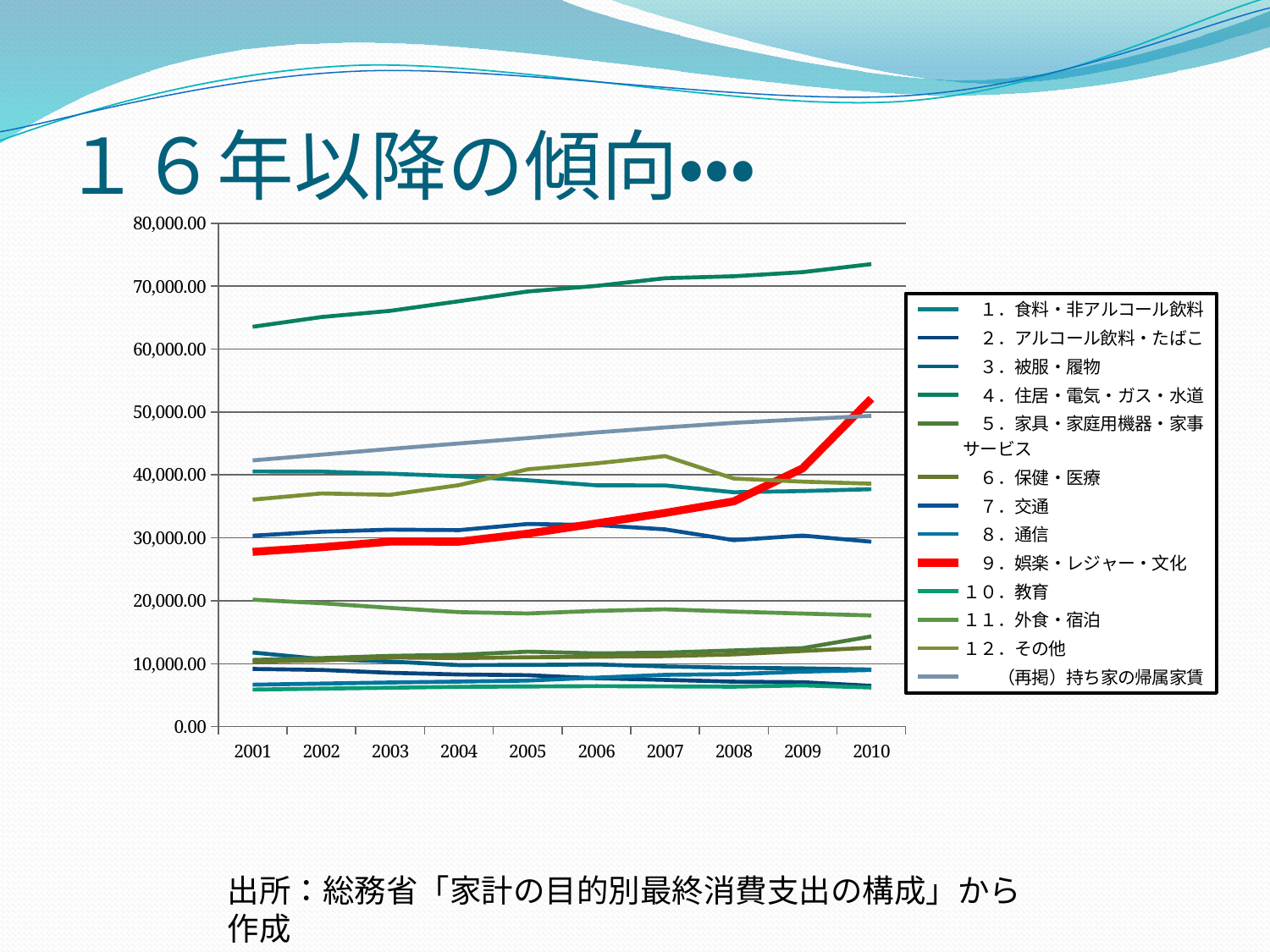
What is the first year shown on the x axis of the chart? 2001 Which series is drawn with the thick red line in the chart? 9．娯楽・レジャー・文化 Does the line for 4．住居・電気・ガス・水道 rise or fall from 2001 to 2010? rise Is the value for 4．住居・電気・ガス・水道 in 2001 greater or less than 60,000.00? greater In 2001, which is larger: 9．娯楽・レジャー・文化 or （再掲）持ち家の帰属家賃? （再掲）持ち家の帰属家賃 How many series does the chart's legend list? 13 How many years are plotted along the x axis of the chart? 10 Which series is the highest line across all years in the chart? 4．住居・電気・ガス・水道 What kind of chart is shown on the slide? line chart Is the value for 4．住居・電気・ガス・水道 in 2010 greater or less than 70,000.00? greater Is the value for 9．娯楽・レジャー・文化 in 2001 greater or less than 30,000.00? less Does the line for 9．娯楽・レジャー・文化 rise or fall from 2001 to 2010? rise